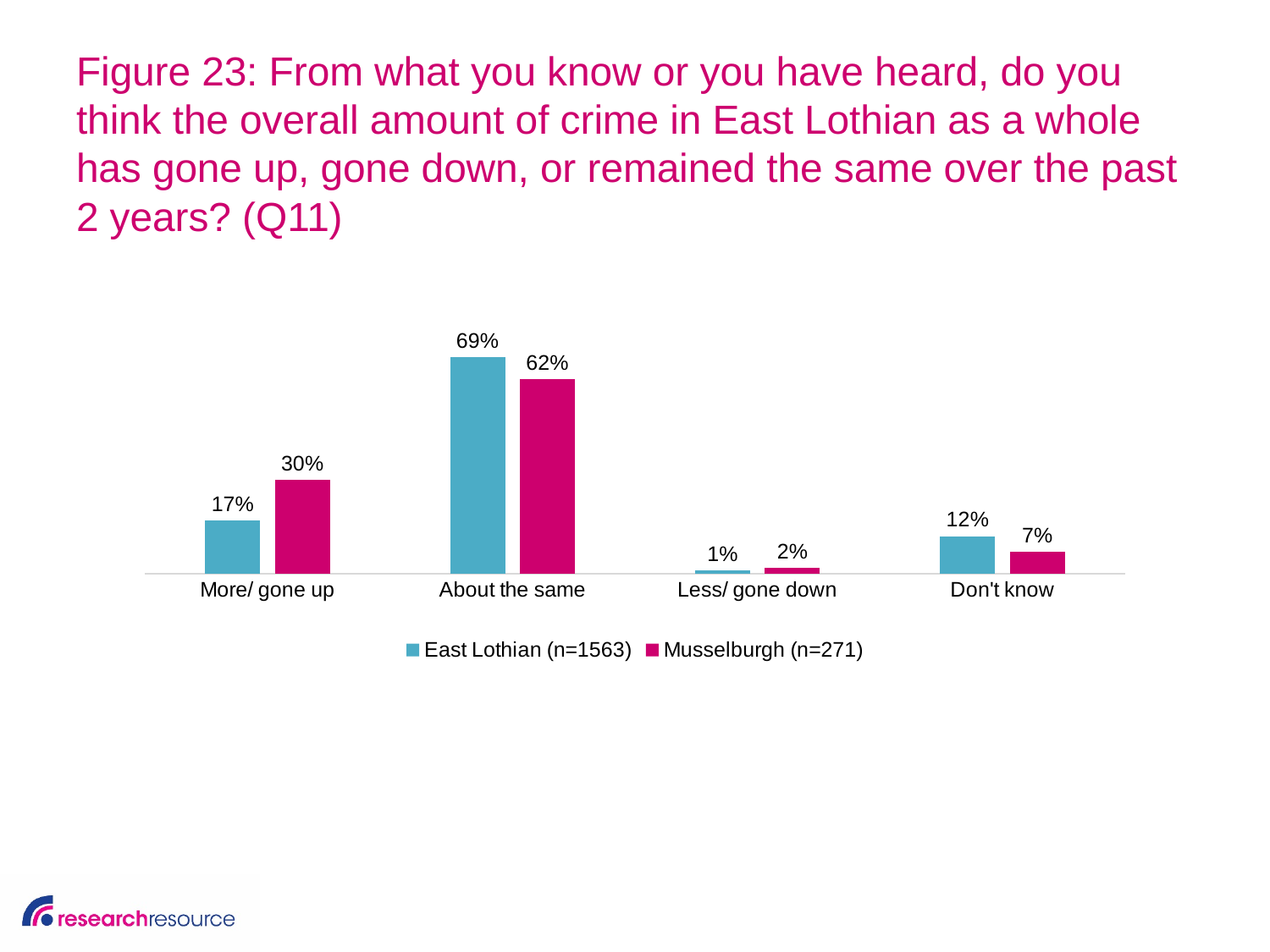
What is the difference between the Musselburgh and East Lothian values for 'More/ gone up'? 13% What percentage of East Lothian respondents said crime has gone up (More/ gone up)? 17% What percentage of Musselburgh respondents said crime is about the same? 62% What is the value for Musselburgh in the 'Don't know' category? 7% What is the difference between the East Lothian and Musselburgh values for 'About the same'? 7% How many series does the legend list? 2 Which is larger for 'Don't know': East Lothian or Musselburgh? East Lothian What type of chart is shown on the slide? Bar chart How many response categories are shown on the x axis? 4 What is the sample size (n) for the Musselburgh series in the legend? 271 Which category has the highest value for East Lothian? About the same Which category has the lowest value for Musselburgh? Less/ gone down